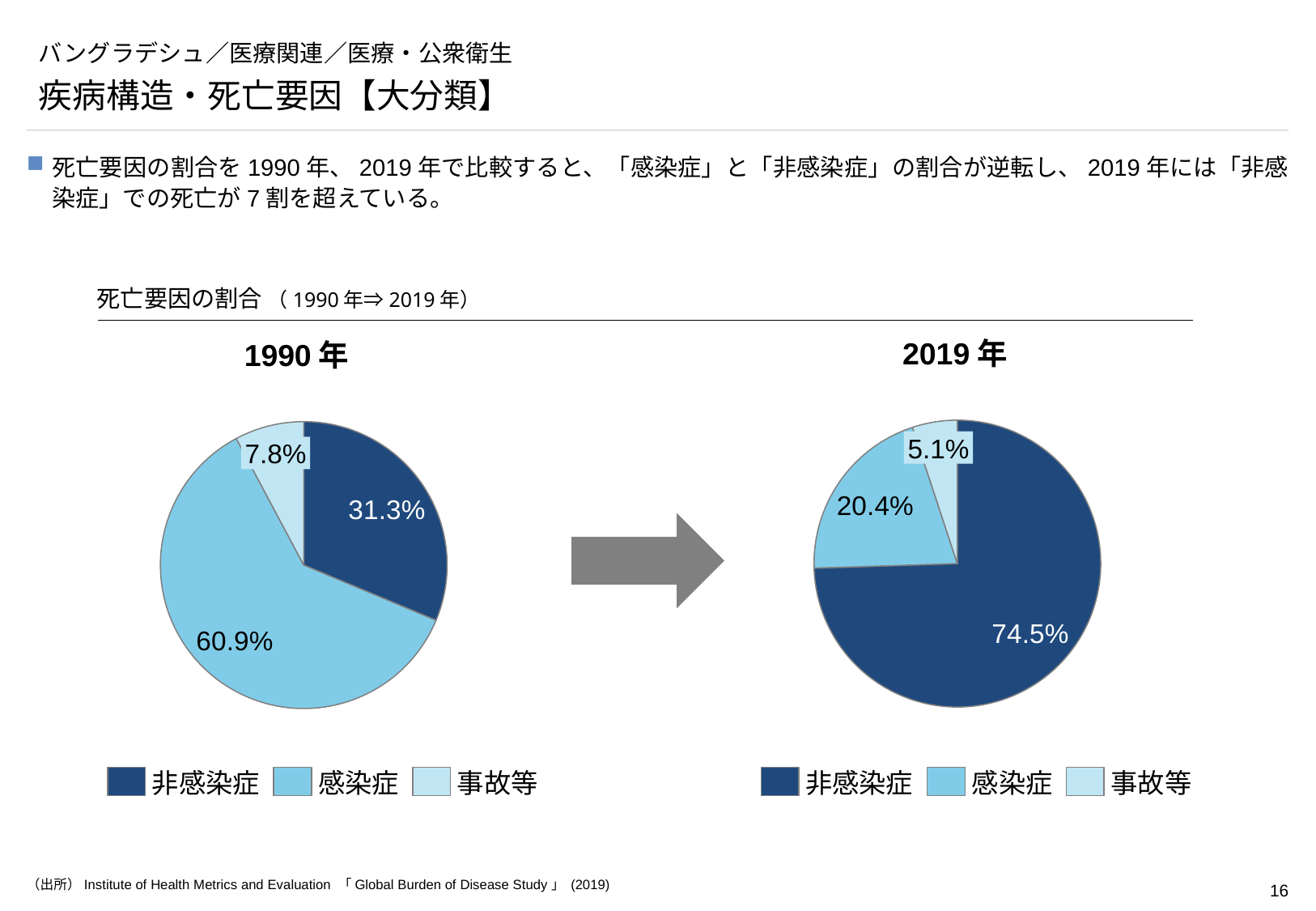
How many entries does the legend under the 2019年 chart list? 3 In the 1990年 pie chart, what share is 感染症? 60.9% In the 2019年 pie chart, what is the difference between the 非感染症 share and the 感染症 share? 54.1% How many categories does the 1990年 pie chart show? 3 In the 1990年 pie chart, which category has the largest share? 感染症 In the 2019年 pie chart, which category has the smallest share? 事故等 In the 1990年 pie chart, what share is 非感染症? 31.3% What is the title of the chart section containing the two pie charts? 死亡要因の割合（1990年⇒2019年） In the 2019年 pie chart, what share is 事故等? 5.1% What kind of chart is used for the 2019年 data? pie chart In the 2019年 pie chart, what share is 非感染症? 74.5% Which is larger: the 事故等 share in the 1990年 pie chart or in the 2019年 pie chart? 1990年